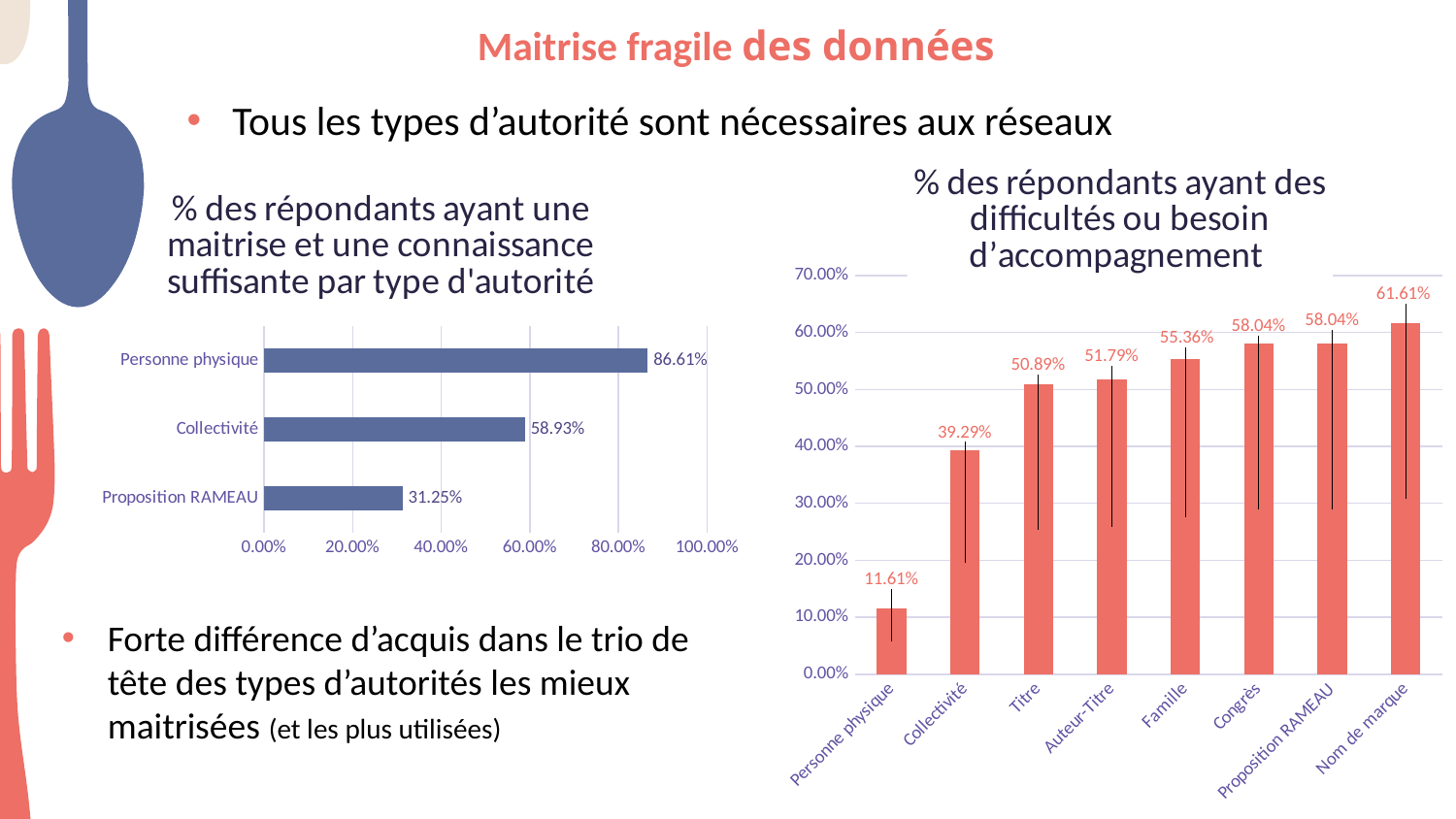
In the right chart (% des répondants ayant des difficultés ou besoin d'accompagnement), how many categories are shown on the x axis? 8 In the left chart (% des répondants ayant une maitrise et une connaissance suffisante par type d'autorité), what is the value for Proposition RAMEAU? 31.25% In the left chart (% des répondants ayant une maitrise et une connaissance suffisante par type d'autorité), which category has the lowest value? Proposition RAMEAU In the right chart (% des répondants ayant des difficultés ou besoin d'accompagnement), what is the value for Titre? 50.89% In the left chart (% des répondants ayant une maitrise et une connaissance suffisante par type d'autorité), what is the difference between Personne physique and Collectivité? 27.68% In the right chart (% des répondants ayant des difficultés ou besoin d'accompagnement), what is the value for Nom de marque? 61.61% In the left chart (% des répondants ayant une maitrise et une connaissance suffisante par type d'autorité), what is the value for Personne physique? 86.61% In the right chart (% des répondants ayant des difficultés ou besoin d'accompagnement), which category has the highest value? Nom de marque In the right chart (% des répondants ayant des difficultés ou besoin d'accompagnement), do the values rise or fall from left to right along the x axis? Rise What type of chart is the left chart (% des répondants ayant une maitrise et une connaissance suffisante par type d'autorité)? Bar chart In the right chart (% des répondants ayant des difficultés ou besoin d'accompagnement), which category has the lowest value? Personne physique In the left chart (% des répondants ayant une maitrise et une connaissance suffisante par type d'autorité), how many categories are shown? 3